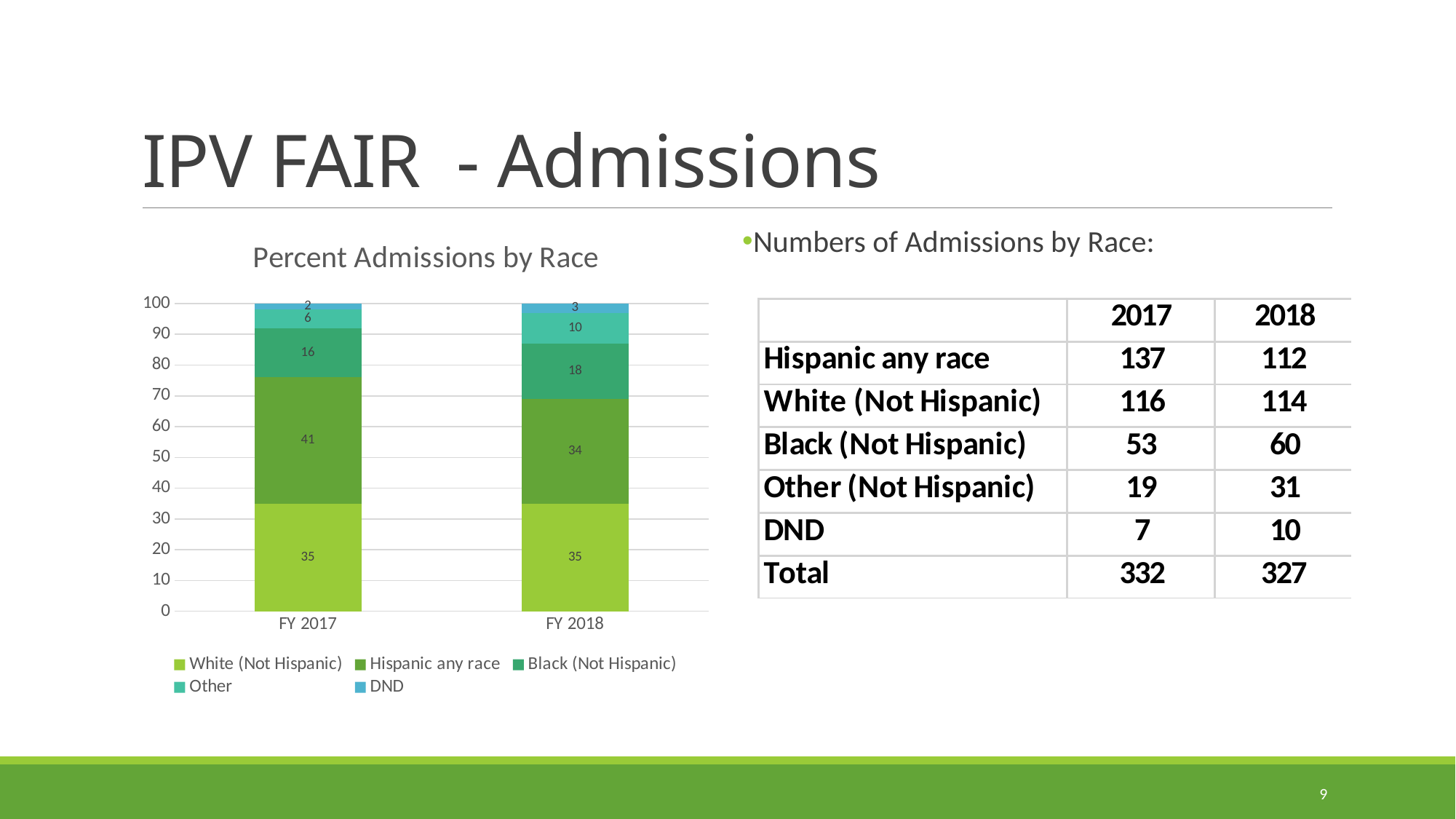
What is the value for DND in FY 2017 in the Percent Admissions by Race chart? 2 What is the value for Other in FY 2018 in the Percent Admissions by Race chart? 10 Which series has the largest value in the FY 2018 bar of the Percent Admissions by Race chart? White (Not Hispanic) Which series has the smallest value in the FY 2017 bar of the Percent Admissions by Race chart? DND How many categories are shown on the x axis of the Percent Admissions by Race chart? 2 What is the difference between the Hispanic any race values for FY 2017 and FY 2018 in the Percent Admissions by Race chart? 7 In the Percent Admissions by Race chart, is the Other value larger in FY 2017 or FY 2018? FY 2018 What kind of chart is the Percent Admissions by Race chart? Stacked bar chart What is the total of the FY 2017 stacked bar in the Percent Admissions by Race chart? 100 What is the value for Hispanic any race in FY 2017 in the Percent Admissions by Race chart? 41 What is the value for Black (Not Hispanic) in FY 2018 in the Percent Admissions by Race chart? 18 How many series does the legend of the Percent Admissions by Race chart list? 5